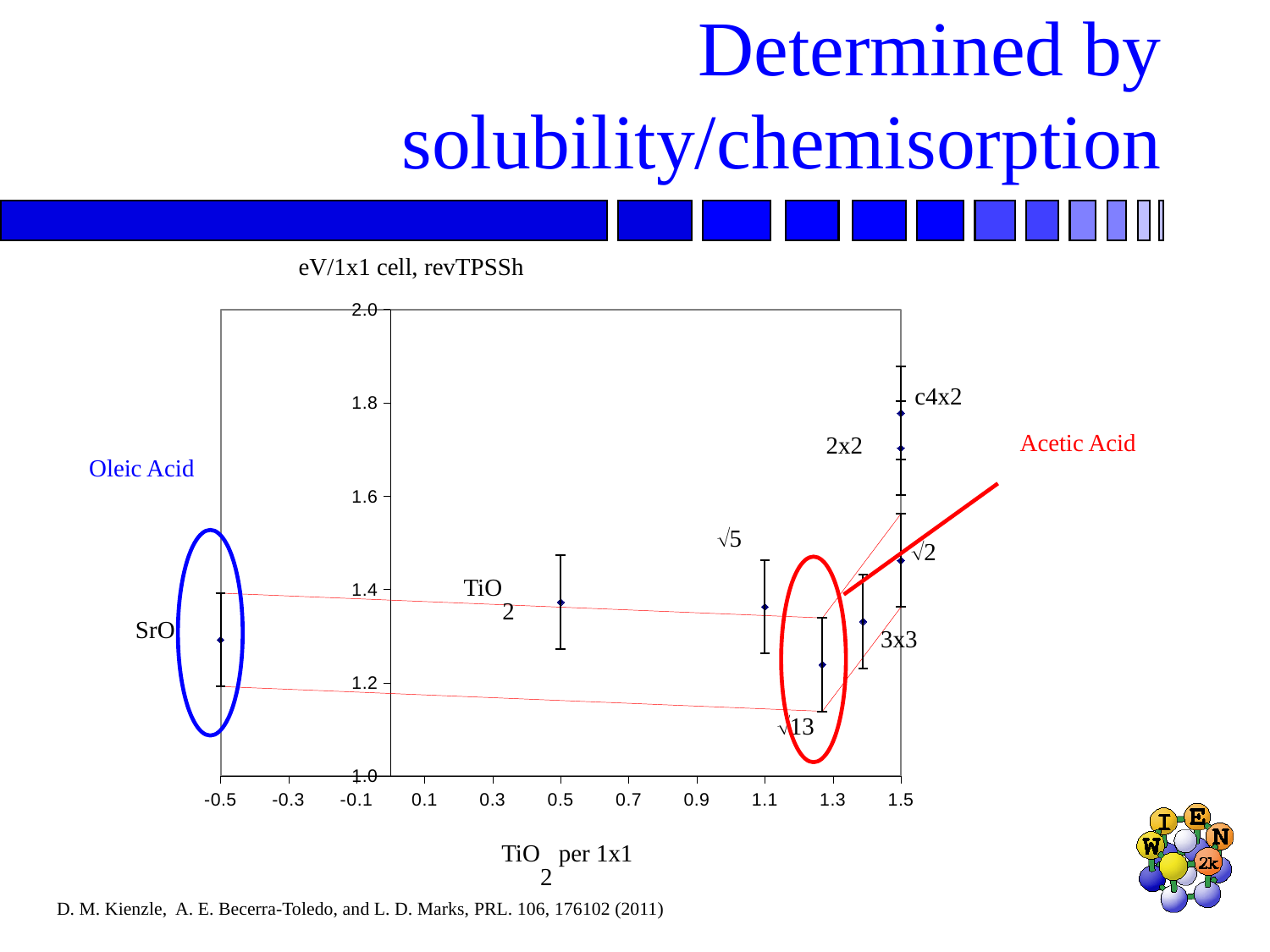
Which has the higher vertical-axis value, 2x2 or √2? 2x2 Which labeled point has the highest value on the vertical axis? c4x2 Is the value for c4x2 greater or less than 1.6? greater Is the value for SrO greater or less than 1.4? less Is the value for 2x2 greater or less than 1.6? greater Which has the higher vertical-axis value, c4x2 or SrO? c4x2 What kind of chart is shown on the slide? scatter chart How many labeled data points are plotted on the chart? 8 Which labeled point has the lowest value on the vertical axis? √13 What is the maximum value shown on the vertical axis of the chart? 2.0 What is the label on the vertical axis of the chart? eV/1x1 cell, revTPSSh